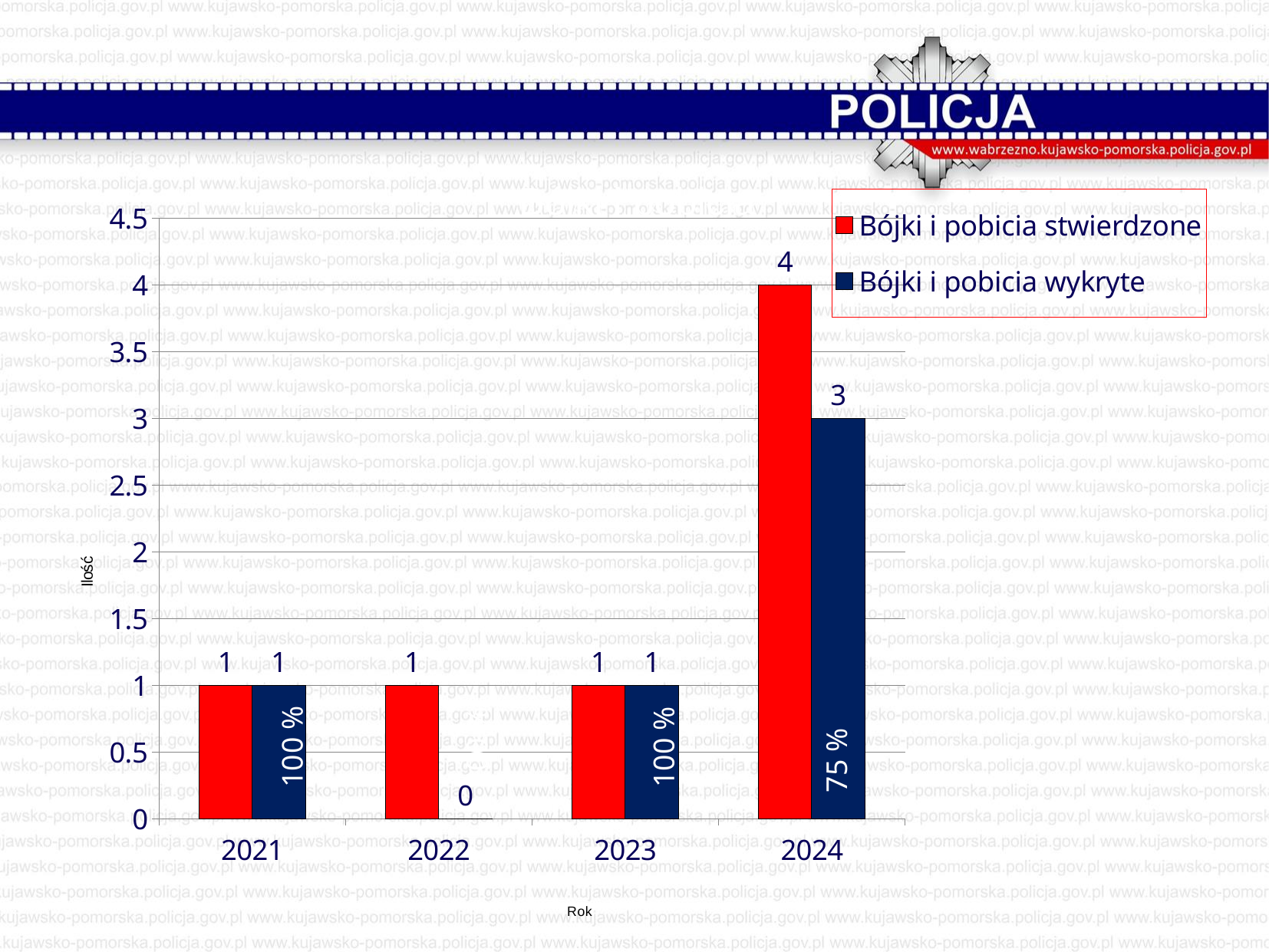
What is the value of Bójki i pobicia stwierdzone in 2021? 1 What percentage label is shown on the Bójki i pobicia wykryte bar for 2024? 75 % What is the difference between Bójki i pobicia stwierdzone and Bójki i pobicia wykryte in 2024? 1 Which year has the highest value for Bójki i pobicia stwierdzone? 2024 What is the value of Bójki i pobicia stwierdzone in 2024? 4 How many years are shown on the x axis? 4 Which year has the lowest value for Bójki i pobicia wykryte? 2022 Which is larger in 2024: Bójki i pobicia stwierdzone or Bójki i pobicia wykryte? Bójki i pobicia stwierdzone How many series does the legend list? 2 What is the value of Bójki i pobicia wykryte in 2022? 0 What is the value of Bójki i pobicia wykryte in 2024? 3 What kind of chart is shown on the slide? bar chart